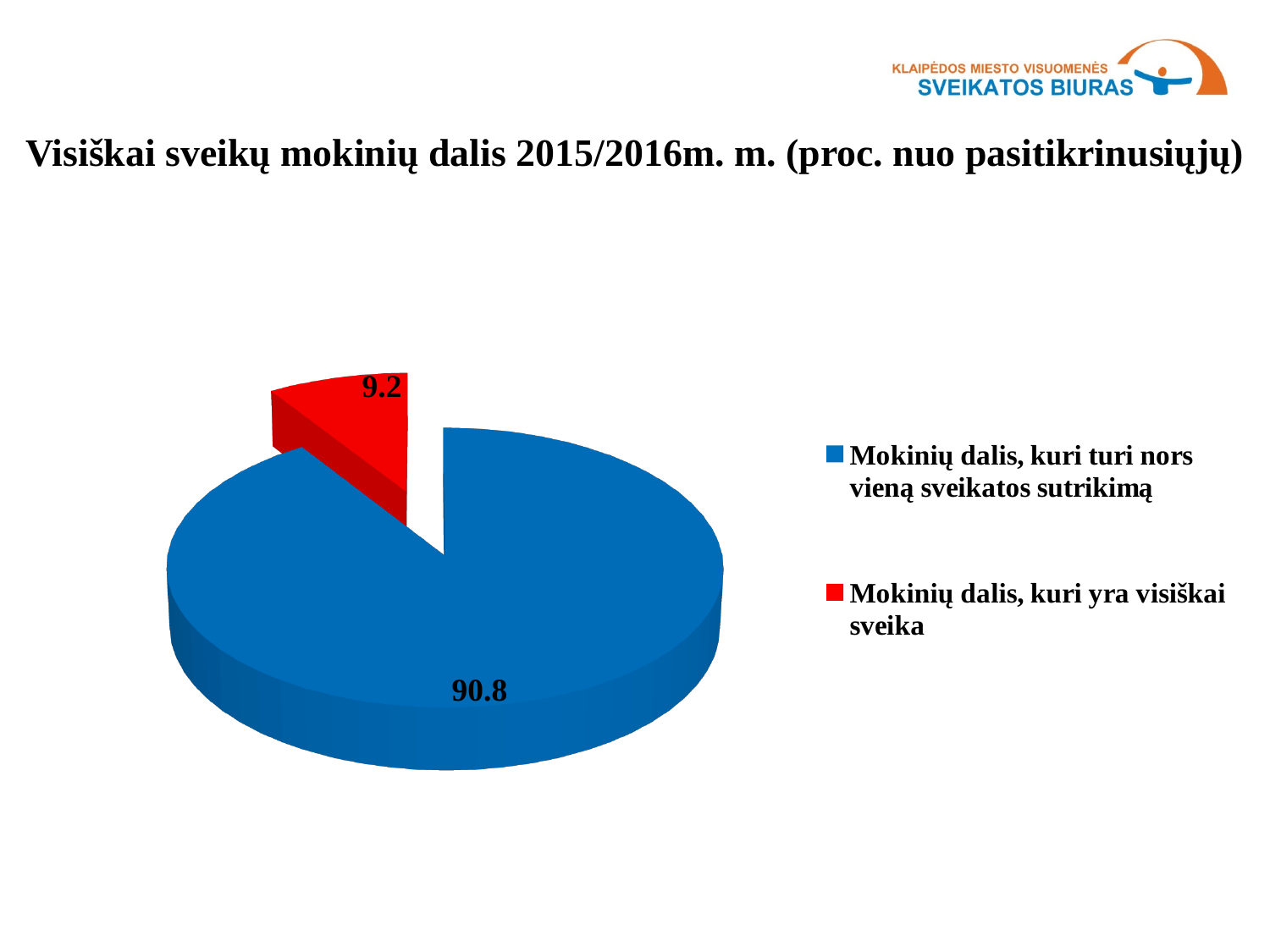
How many slices does the pie chart have? 2 Which category has the smallest slice of the pie? Mokinių dalis, kuri yra visiškai sveika What is the value for "Mokinių dalis, kuri turi nors vieną sveikatos sutrikimą"? 90.8 What is the value for "Mokinių dalis, kuri yra visiškai sveika"? 9.2 What is the difference between the value for "Mokinių dalis, kuri turi nors vieną sveikatos sutrikimą" and the value for "Mokinių dalis, kuri yra visiškai sveika"? 81.6 Which is larger: the value for "Mokinių dalis, kuri yra visiškai sveika" or the value for "Mokinių dalis, kuri turi nors vieną sveikatos sutrikimą"? Mokinių dalis, kuri turi nors vieną sveikatos sutrikimą What colour is the slice for "Mokinių dalis, kuri yra visiškai sveika"? red What kind of chart is shown on the slide? pie chart What is the total of the two slice values shown on the pie chart? 100 What is the title of the chart on the slide? Visiškai sveikų mokinių dalis 2015/2016m. m. (proc. nuo pasitikrinusiųjų) Which category has the largest slice of the pie? Mokinių dalis, kuri turi nors vieną sveikatos sutrikimą How many entries does the legend list? 2